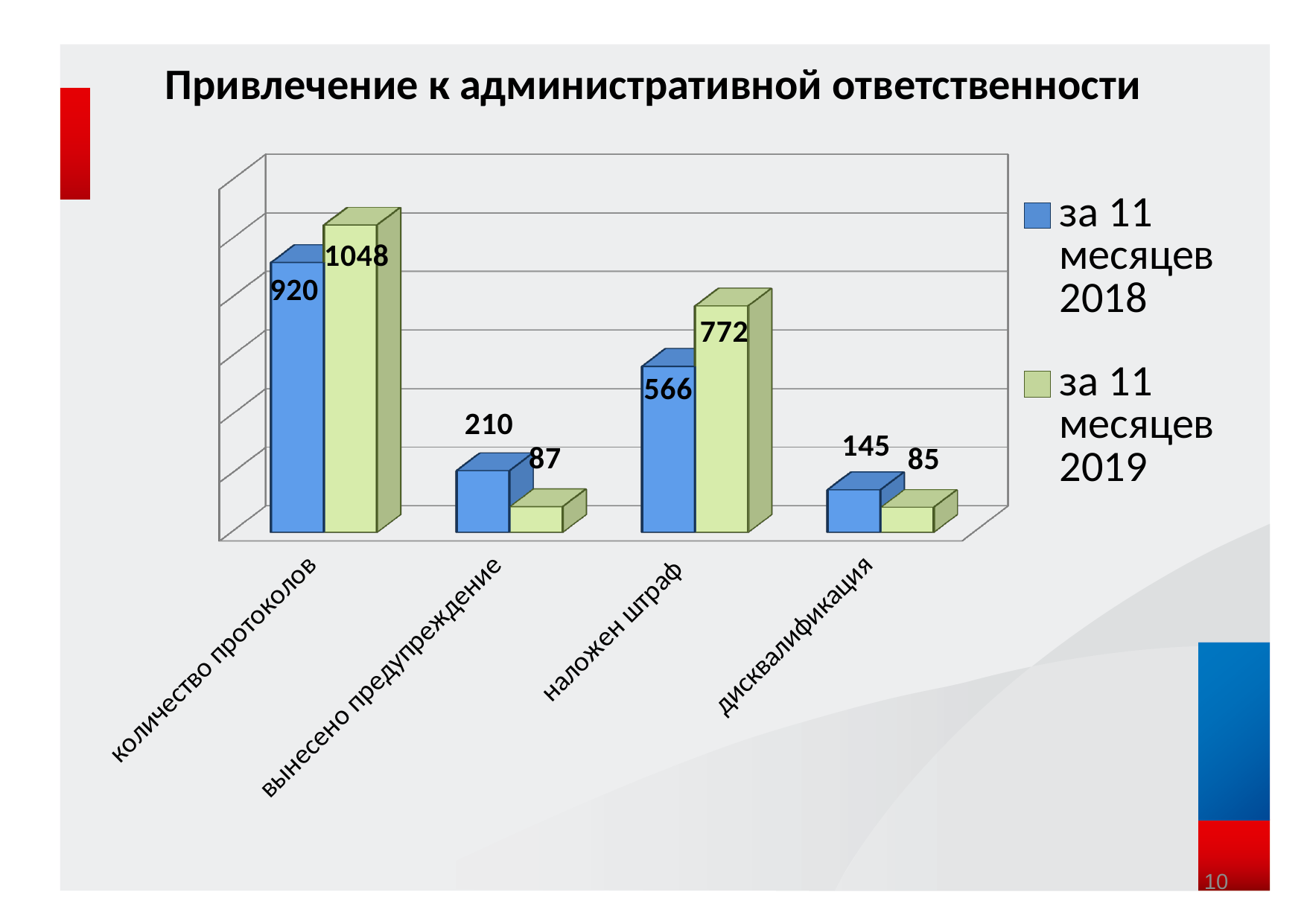
What type of chart is shown on the slide? Bar chart How many categories are shown on the x axis of the chart? 4 What is the value for "количество протоколов" in the series "за 11 месяцев 2019"? 1048 How many series does the legend list? 2 What is the difference between the 2019 and 2018 values for "наложен штраф"? 206 What is the difference between the 2018 and 2019 values for "вынесено предупреждение"? 123 Which category has the lowest value in the series "за 11 месяцев 2019"? дисквалификация What is the value for "дисквалификация" in the series "за 11 месяцев 2018"? 145 For "дисквалификация", which series has the larger value: "за 11 месяцев 2018" or "за 11 месяцев 2019"? за 11 месяцев 2018 Which category has the highest value in the series "за 11 месяцев 2019"? количество протоколов What is the value for "количество протоколов" in the series "за 11 месяцев 2018"? 920 What is the value for "наложен штраф" in the series "за 11 месяцев 2019"? 772